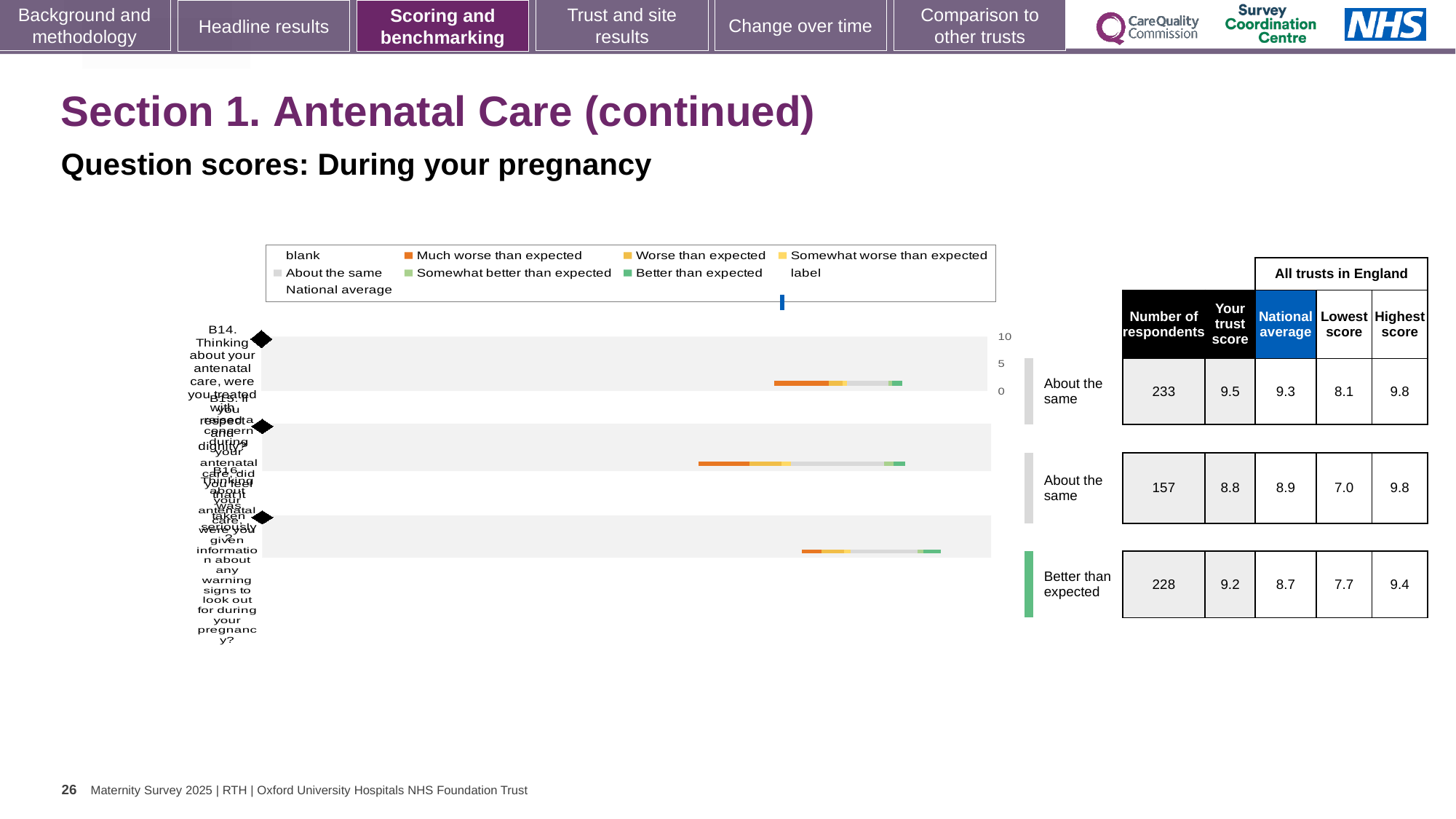
In the table beside the chart, for the second row, which is larger: the trust score or the national average? the national average (8.9) In the table beside the chart, what is the lowest score for the second row? 7.0 What kind of chart is shown on the slide? bar chart In the table beside the chart, what is the number of respondents for the first row? 233 In the table beside the chart, what is the difference between the trust score and the national average for the third row (Better than expected)? 0.5 In the table beside the chart, what is the highest score for the first row? 9.8 In the table beside the chart, which row has the highest number of respondents? the first row (233) In the table beside the chart, what is the trust score for the third row (Better than expected)? 9.2 In the table beside the chart, what is the national average for the second row? 8.9 How many question rows (bars) does the chart show? 3 What is the maximum value shown on the chart's numeric axis? 10 In the chart legend, what colour represents 'Much worse than expected'? orange